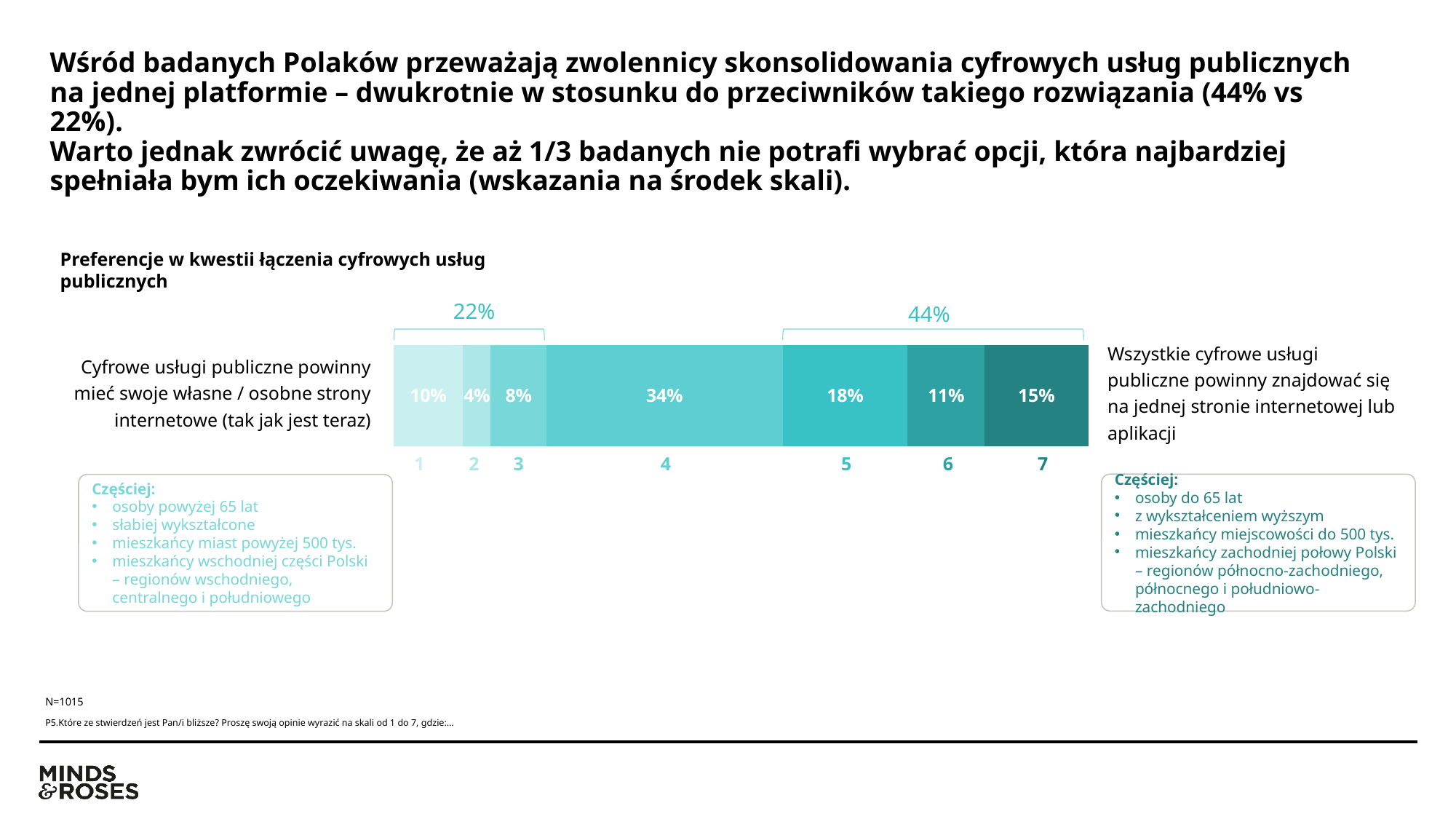
What combined percentage is shown by the bracket over points 5 to 7? 44% Which scale point has the lowest share of respondents? 2 What combined percentage is shown by the bracket over points 1 to 3? 22% Which has a larger share of respondents, point 3 or point 6? 6 What percentage of respondents chose point 1 on the scale? 10% Which scale point has the highest share of respondents? 4 What percentage of respondents chose point 4 on the scale? 34% What percentage of respondents chose point 7 on the scale? 15% What is the title of the chart? Preferencje w kwestii łączenia cyfrowych usług publicznych What is the difference between the share for point 5 and the share for point 6? 7% What kind of chart is shown on the slide? Stacked bar chart How many scale points are shown in the bar? 7